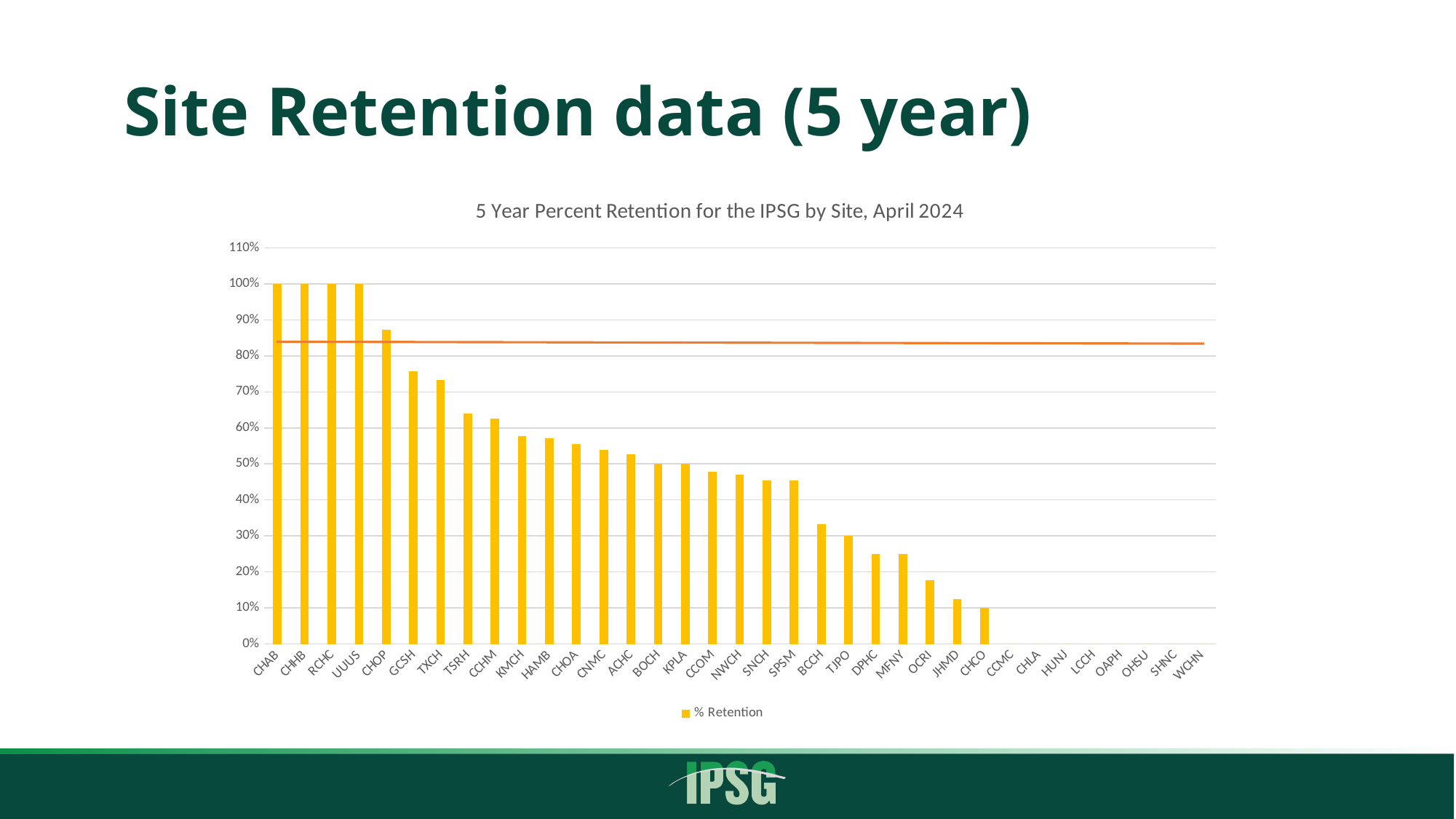
Do the retention values rise or fall moving from left to right along the x axis? Fall What kind of chart is shown on the slide? Bar chart What series name is listed in the chart legend? % Retention Is the value for TSRH greater or less than 60%? greater Which site has the higher retention, CHOP or GCSH? CHOP How many sites are listed along the x axis of the chart? 35 Is the value for OCRI greater or less than 20%? less Is the value for GCSH greater or less than 80%? less What is the 5 year percent retention for CHAB? 100% What is the title of the chart? 5 Year Percent Retention for the IPSG by Site, April 2024 What is the 5 year percent retention for UUUS? 100%